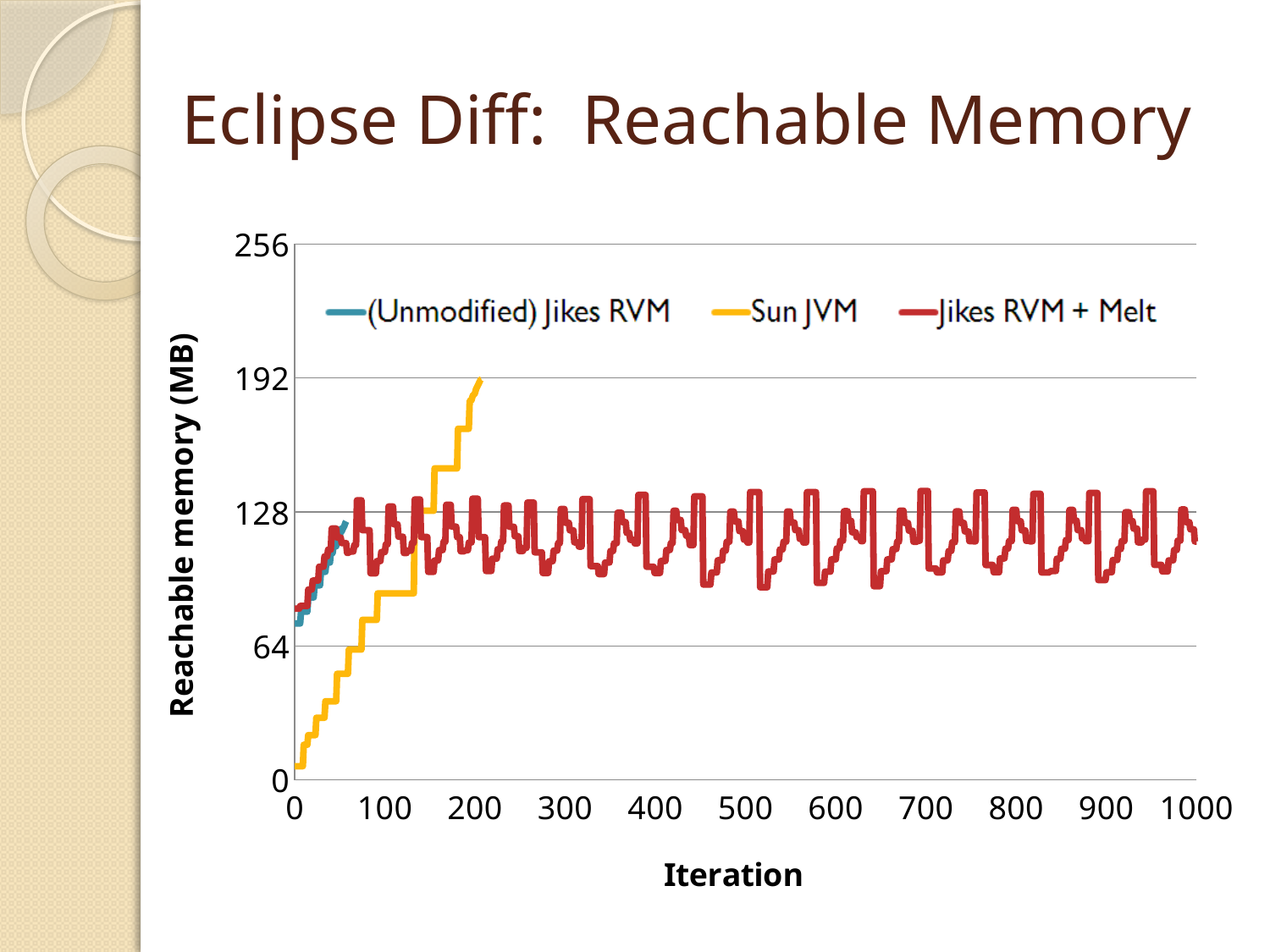
Which series extends all the way to iteration 1000? Jikes RVM + Melt What is the label of the y axis? Reachable memory (MB) What is the title of the slide's chart? Eclipse Diff: Reachable Memory Is the value for Sun JVM at iteration 0 greater or less than 64? less Is the highest value reached by Jikes RVM + Melt greater or less than 192? less How many series does the legend list? 3 Which series reaches the highest reachable memory value on the chart? Sun JVM What kind of chart is shown on the slide? line chart Is the value for Jikes RVM + Melt at iteration 1000 greater or less than 64? greater Does the Sun JVM series rise or fall as the iteration increases? rise At iteration 200, which series has the larger value: Sun JVM or Jikes RVM + Melt? Sun JVM